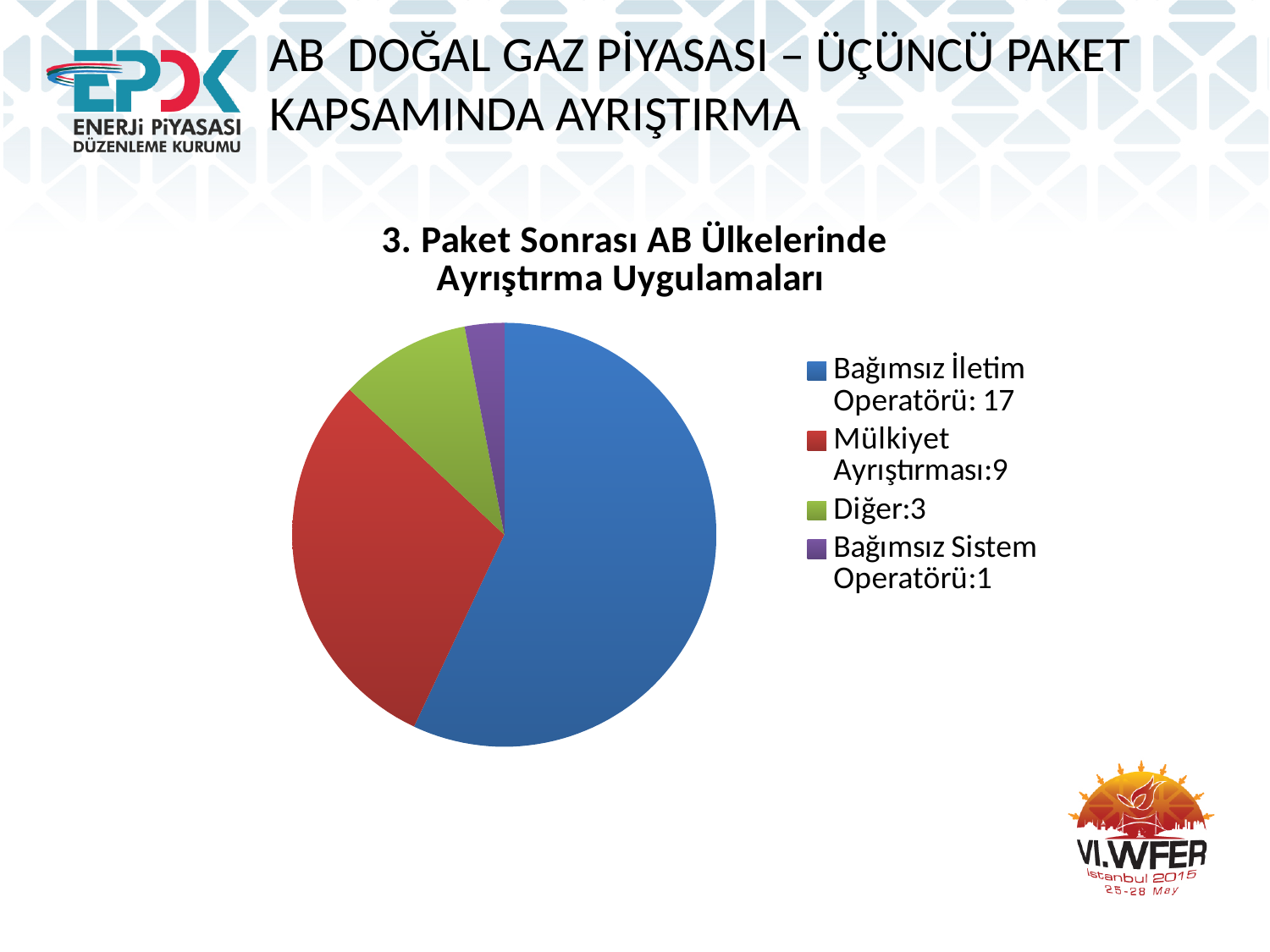
What is the value for Bağımsız Sistem Operatörü? 1 Which category has the largest slice of the pie? Bağımsız İletim Operatörü What kind of chart is shown on the slide? Pie chart Which is larger, the value for Mülkiyet Ayrıştırması or the value for Diğer? Mülkiyet Ayrıştırması What is the title of the chart? 3. Paket Sonrası AB Ülkelerinde Ayrıştırma Uygulamaları What is the value for Diğer? 3 What share of the pie does Mülkiyet Ayrıştırması represent? 30% What is the value for Bağımsız İletim Operatörü? 17 What is the value for Mülkiyet Ayrıştırması? 9 How many slices does the pie chart have? 4 Which category has the smallest slice of the pie? Bağımsız Sistem Operatörü What is the difference between the values for Bağımsız İletim Operatörü and Mülkiyet Ayrıştırması? 8